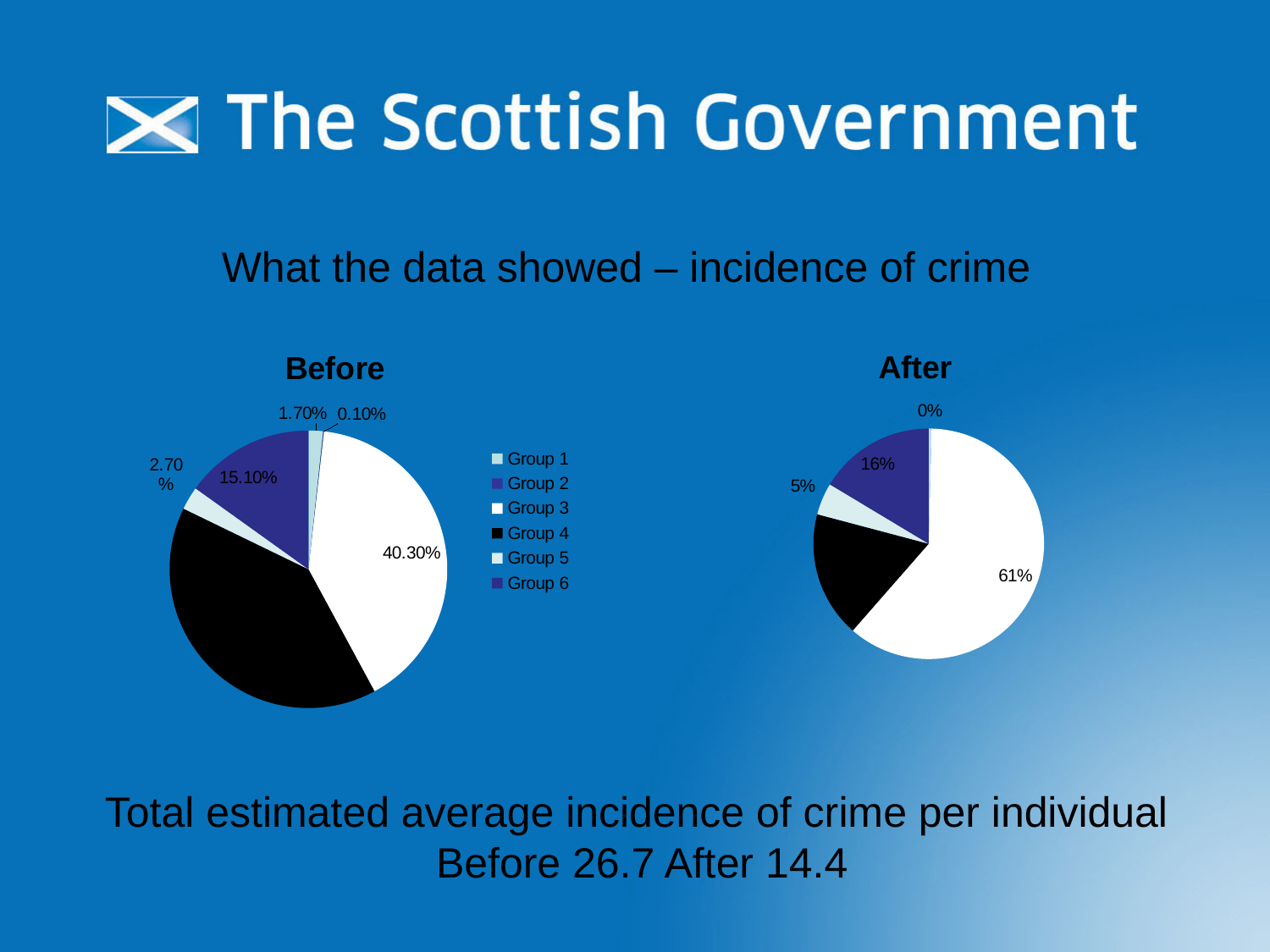
What type of chart is used for the Before and After data? Pie chart In the After pie chart, what percentage is shown for Group 6? 16% How many groups does the legend list? 6 In the Before pie chart, what percentage is shown for Group 3? 40.30% In the After pie chart, which group has the largest slice? Group 3 In the After pie chart, what percentage is shown for Group 3? 61% In the After pie chart, what is the difference between the Group 3 and Group 6 percentages? 45% In the Before pie chart, which is larger, Group 6 or Group 5? Group 6 In the Before pie chart, which group has the smallest slice? Group 2 In the Before pie chart, what percentage is shown for Group 5? 2.70% In the Before pie chart, what percentage is shown for Group 6? 15.10% In the After pie chart, what percentage is shown for Group 5? 5%